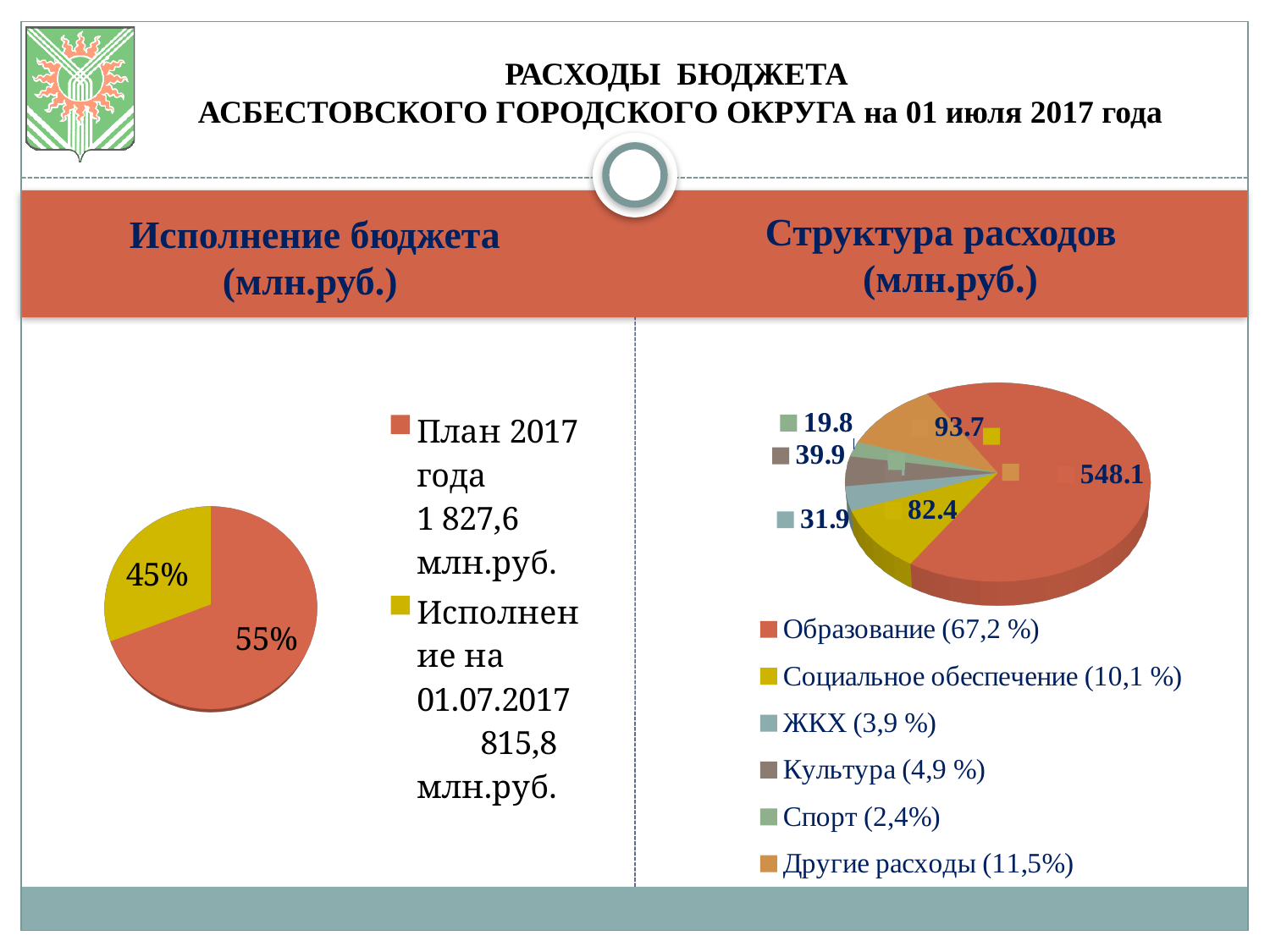
How many categories does the legend of the 'Структура расходов (млн.руб.)' chart list? 6 On the 'Структура расходов (млн.руб.)' chart, what share of expenditures does Образование account for according to the legend? 67,2 % On the 'Исполнение бюджета (млн.руб.)' chart, what percentage is shown for the 'Исполнение на 01.07.2017' slice? 45% On the 'Структура расходов (млн.руб.)' chart, what is the value for Спорт? 19.8 On the 'Структура расходов (млн.руб.)' chart, which category has the largest value? Образование On the 'Исполнение бюджета (млн.руб.)' chart, what percentage is shown for the 'План 2017 года' slice? 55% On the 'Структура расходов (млн.руб.)' chart, what is the difference between Другие расходы and Социальное обеспечение? 11.3 What type of chart is the 'Исполнение бюджета (млн.руб.)' chart? Pie chart On the 'Структура расходов (млн.руб.)' chart, what is the value for Образование? 548.1 On the 'Структура расходов (млн.руб.)' chart, what is the value for Социальное обеспечение? 82.4 On the 'Структура расходов (млн.руб.)' chart, which category has the smallest value? Спорт On the 'Структура расходов (млн.руб.)' chart, which is larger: Культура or ЖКХ? Культура